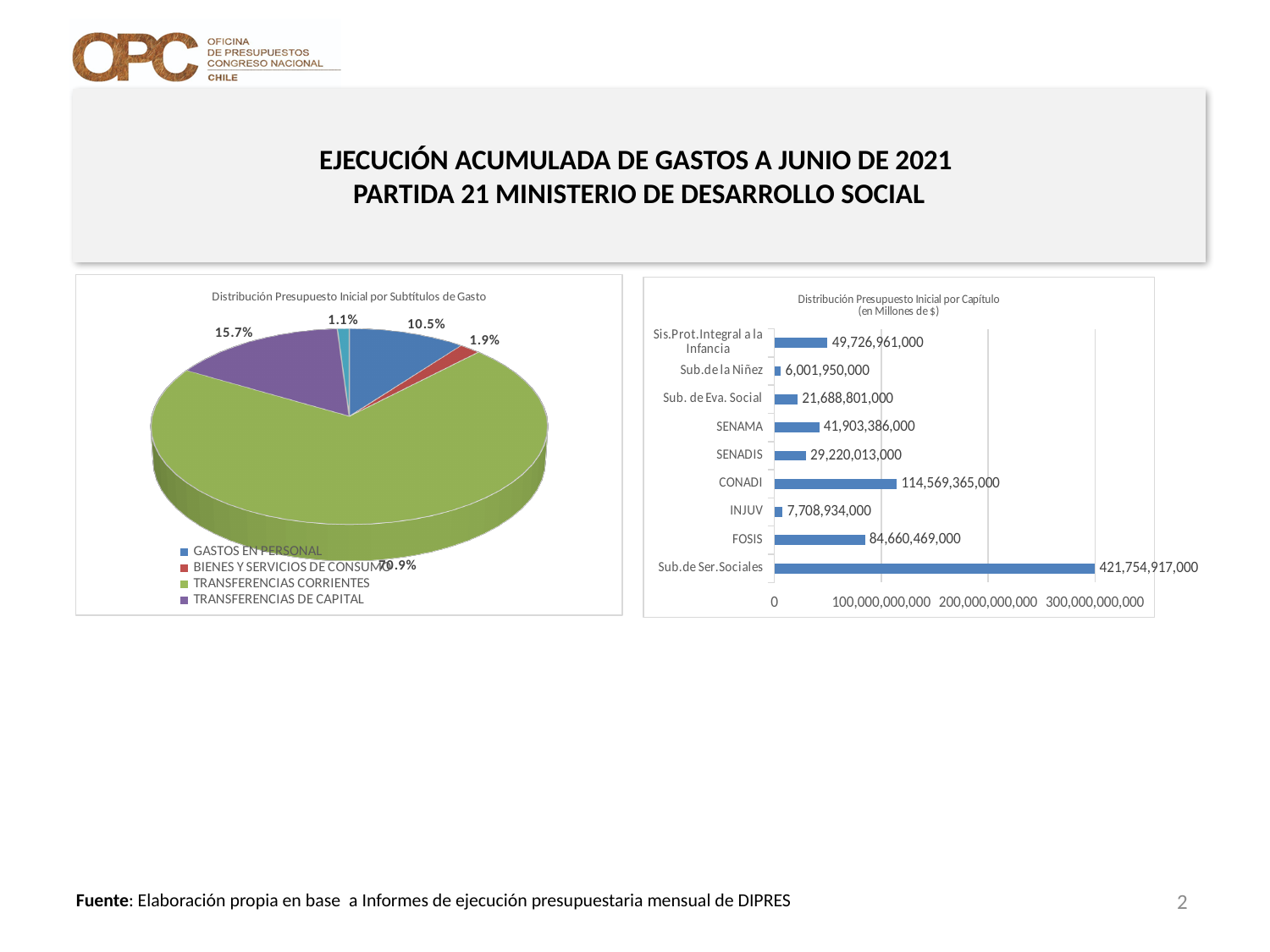
In the pie chart on the left, what share does TRANSFERENCIAS CORRIENTES have? 70.9% In the bar chart on the right, what is the value for FOSIS? 84,660,469,000 In the pie chart on the left, what share does TRANSFERENCIAS DE CAPITAL have? 15.7% What kind of chart is the chart on the right of the slide? Bar chart In the bar chart on the right, which category has the lowest value? Sub.de la Niñez In the bar chart on the right, what is the difference between the values for CONADI and FOSIS? 29,908,896,000 In the bar chart on the right, what is the value for CONADI? 114,569,365,000 What is the title of the chart on the right of the slide? Distribución Presupuesto Inicial por Capítulo (en Millones de $) In the bar chart on the right, which is larger, the value for SENADIS or the value for Sub. de Eva. Social? SENADIS In the bar chart on the right, what is the value for SENAMA? 41,903,386,000 In the bar chart on the right, which category has the highest value? Sub.de Ser.Sociales How many categories are shown in the bar chart on the right? 9